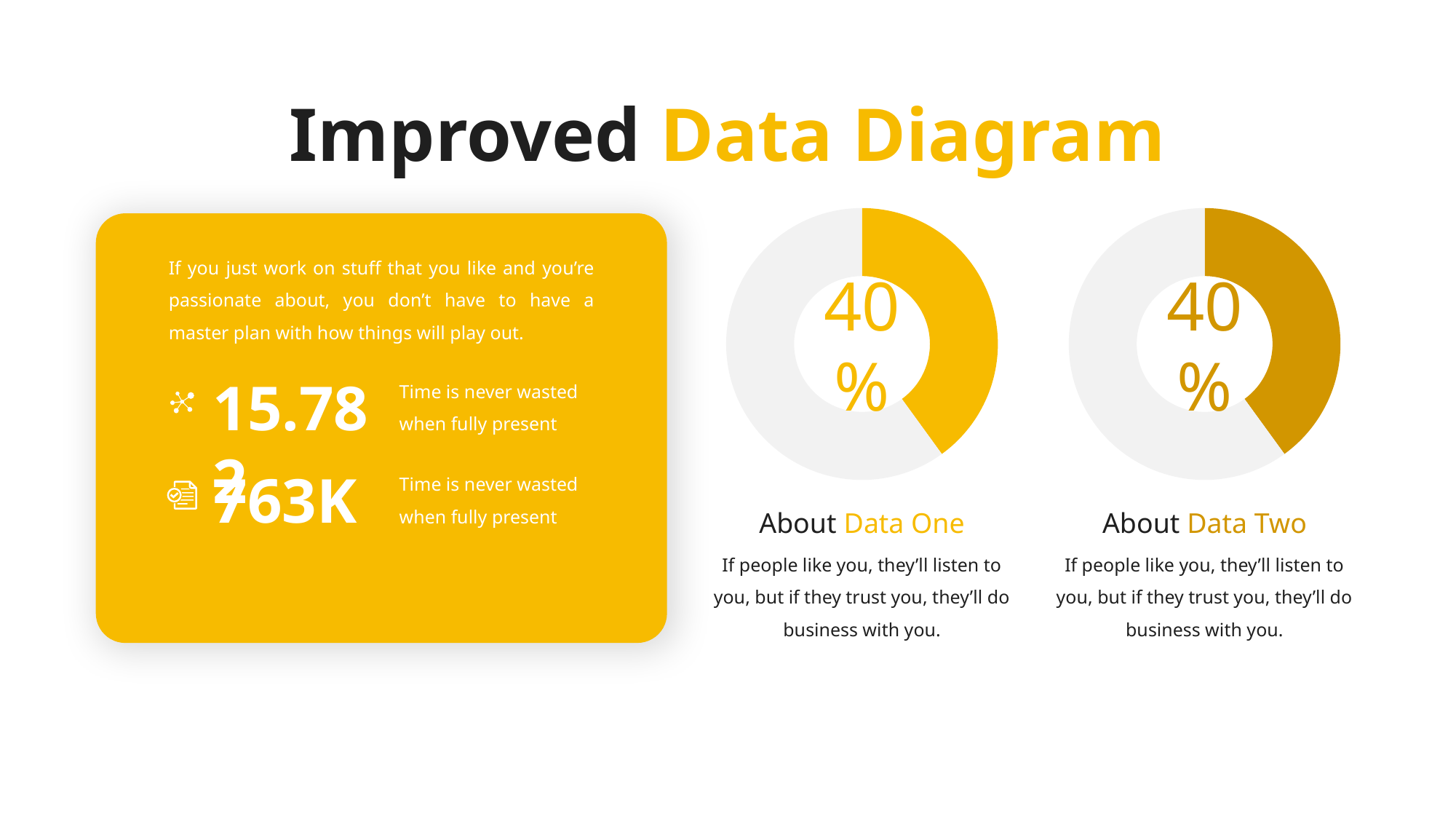
How many segments does the 'About Data One' donut chart have? 2 What percentage is shown in the centre of the 'About Data Two' donut chart? 40% What is the label under the left donut chart? About Data One What kind of chart is used for 'About Data One'? Donut chart In the 'About Data Two' donut chart, is the filled share greater or less than 50%? less What is the label under the right donut chart? About Data Two In the 'About Data One' donut chart, what share of the ring is filled with the coloured segment? 40% In the 'About Data One' donut chart, is the filled share greater or less than 50%? less How many donut charts are shown on the slide? 2 What kind of chart is used for 'About Data Two'? Donut chart What percentage is shown in the centre of the 'About Data One' donut chart? 40%